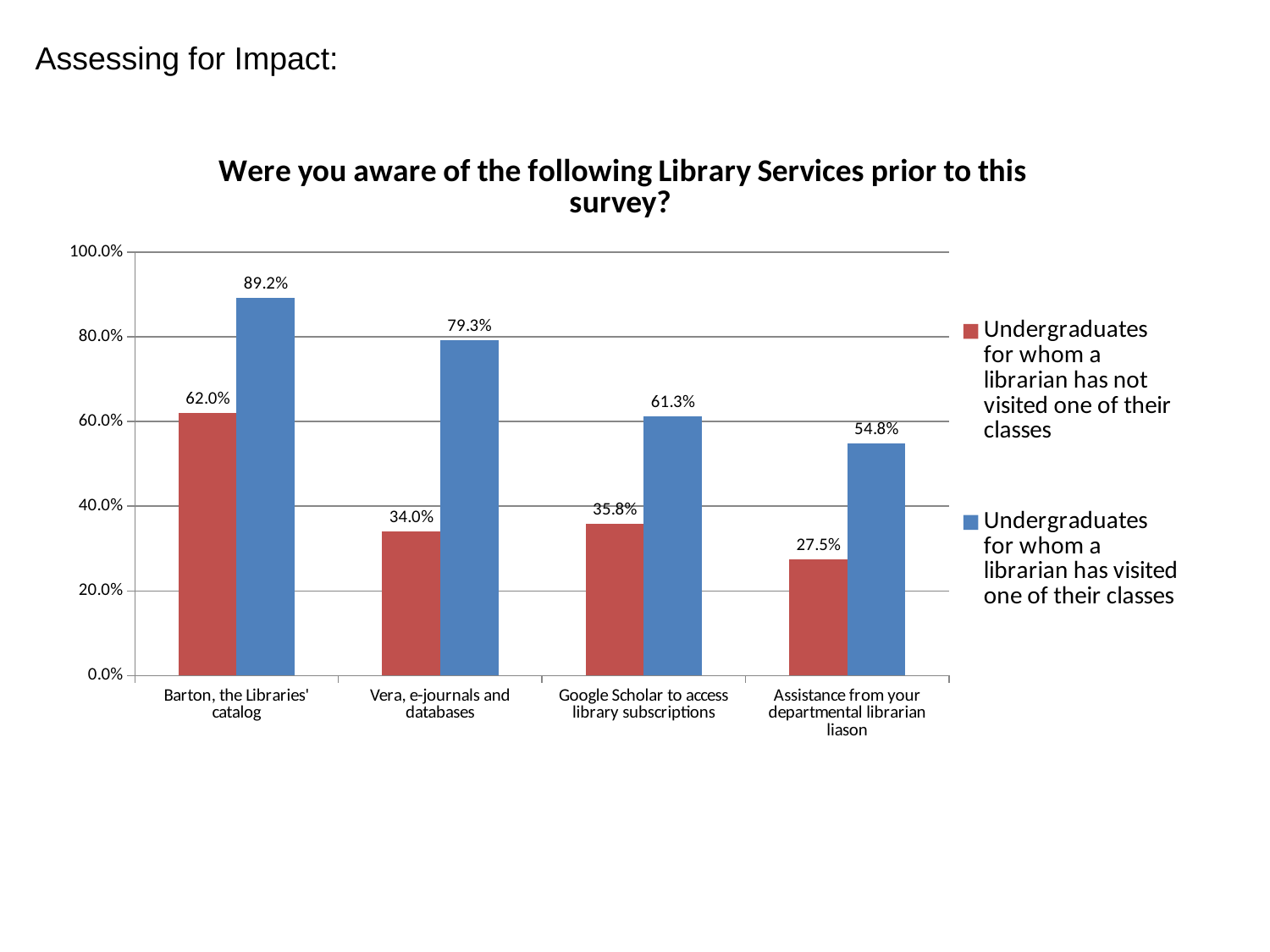
What is the value for Google Scholar to access library subscriptions among undergraduates for whom a librarian has visited one of their classes? 61.3% What percentage of undergraduates for whom a librarian has visited one of their classes were aware of Barton, the Libraries' catalog? 89.2% What is the difference between the two groups' awareness of Vera, e-journals and databases? 45.3% How many series does the legend list? 2 What kind of chart is shown on the slide? Bar chart How many library services are shown on the x axis? 4 Is the value for Barton, the Libraries' catalog among undergraduates for whom a librarian has not visited one of their classes greater or less than 60.0%? greater Which library service has the lowest awareness among undergraduates for whom a librarian has not visited one of their classes? Assistance from your departmental librarian liason For Assistance from your departmental librarian liason, which group has the higher awareness? Undergraduates for whom a librarian has visited one of their classes What is the title of the chart? Were you aware of the following Library Services prior to this survey? Which library service has the highest awareness among undergraduates for whom a librarian has visited one of their classes? Barton, the Libraries' catalog What percentage of undergraduates for whom a librarian has not visited one of their classes were aware of Vera, e-journals and databases? 34.0%